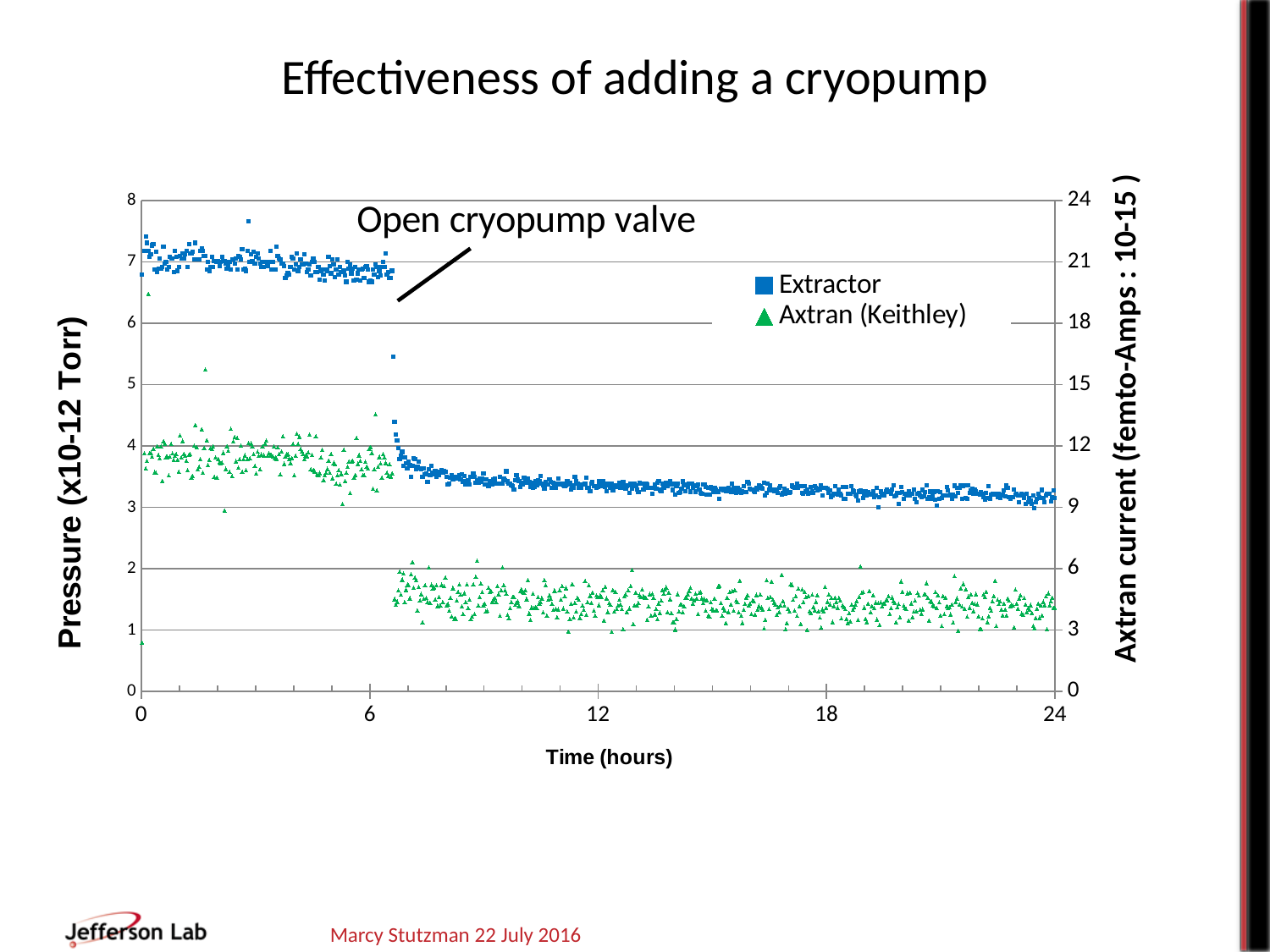
What kind of chart is shown on the slide? scatter chart Is the Axtran (Keithley) current at 12 hours greater or less than 6 on the right axis? less Does the Extractor pressure rise or fall over the 24 hours shown? fall What is the label of the x axis? Time (hours) Is the Axtran (Keithley) current at 3 hours greater or less than 9 on the right axis? greater What is the title of the chart? Effectiveness of adding a cryopump Is the Extractor pressure at 3 hours greater or less than 6 on the left axis? greater How many series does the legend list? 2 Does the Axtran (Keithley) current rise or fall after the cryopump valve is opened? fall Which is larger, the Extractor pressure at 2 hours or the Extractor pressure at 20 hours? at 2 hours